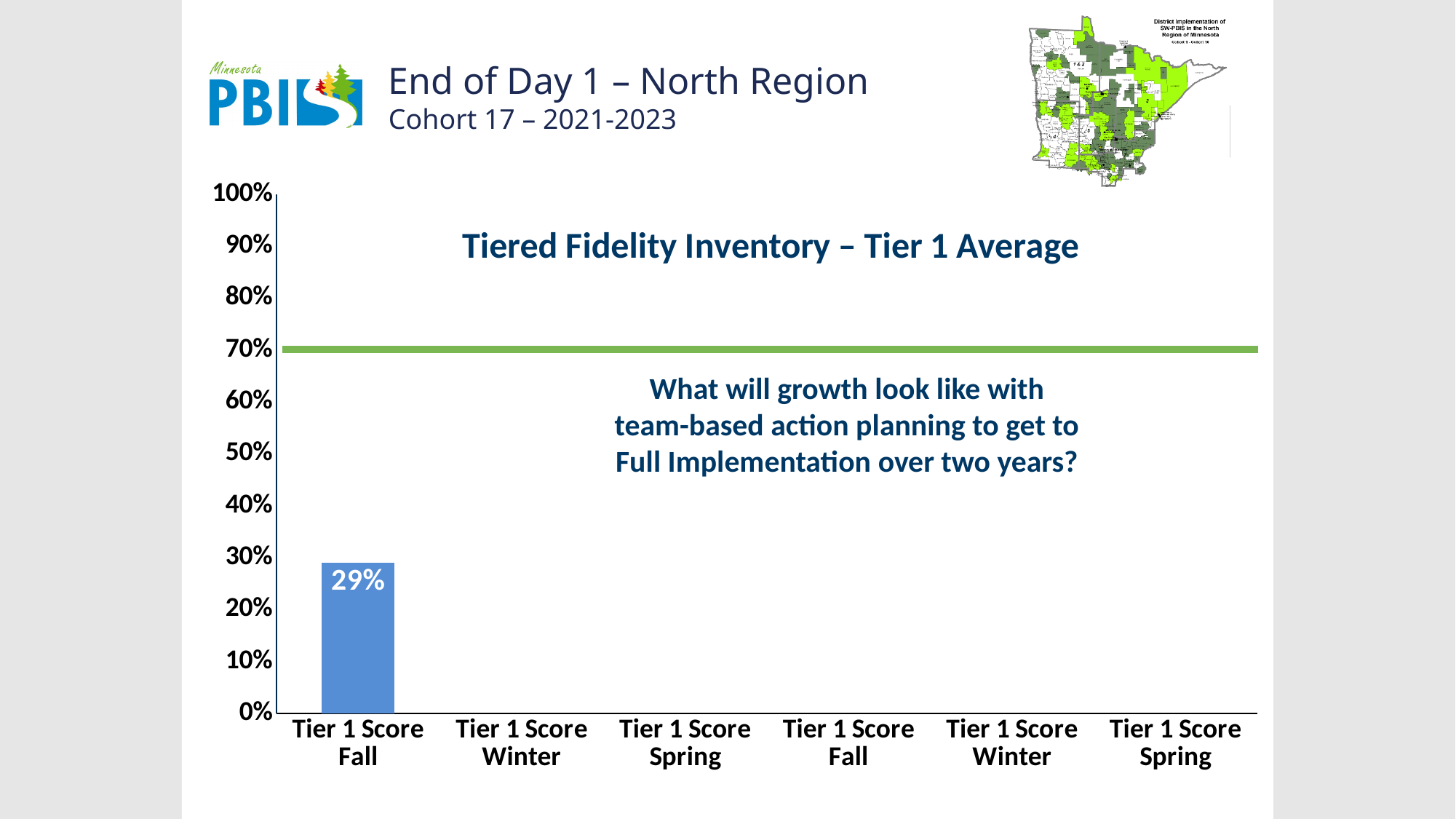
At what percentage level is the green horizontal line drawn across the chart? 70% Is the value for the first Tier 1 Score Fall bar greater or less than 20%? greater What is the value of the first Tier 1 Score Fall bar? 29% Is the value for the first Tier 1 Score Fall bar greater or less than 30%? less How many bars have data plotted in the chart? 1 What is the maximum value shown on the y axis of the chart? 100% What kind of chart is shown on the slide? bar chart How many categories are listed along the x axis of the chart? 6 What is the title of the chart? Tiered Fidelity Inventory – Tier 1 Average Which category has the highest plotted value in the chart? Tier 1 Score Fall Is the first Tier 1 Score Fall bar above or below the green 70% line? below